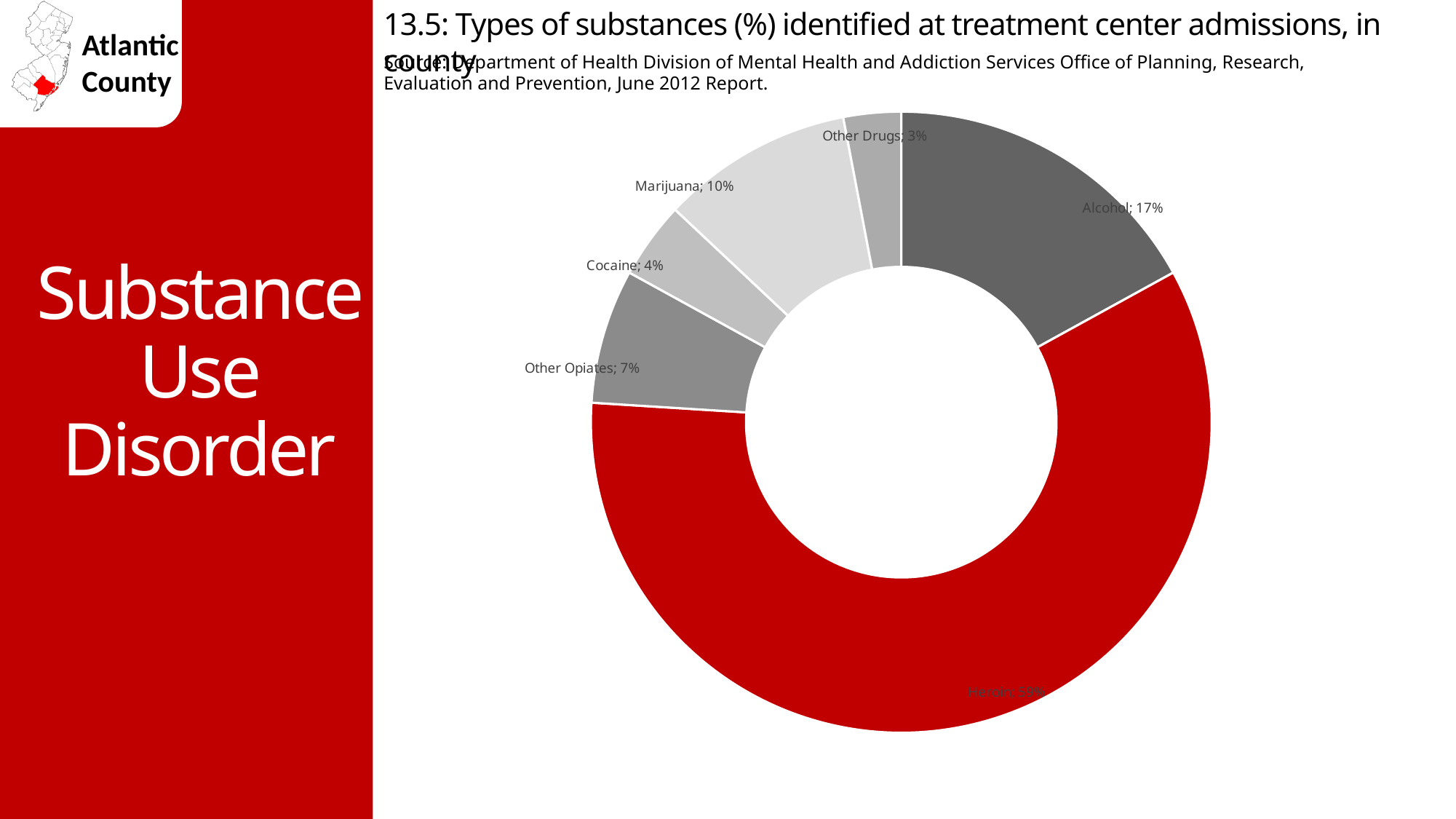
How many substance categories are shown in the chart? 6 What percentage of treatment center admissions is attributed to Alcohol? 17% What is the value shown for Other Opiates? 7% What percentage is shown for Marijuana? 10% Which substance accounts for the smallest share of admissions? Other Drugs What kind of chart is used on this slide? Doughnut (pie) chart What is the difference in percentage points between Alcohol and Marijuana? 7 What percentage is shown for Cocaine? 4% Which substance accounts for the largest share of admissions? Heroin Which has a larger share, Other Opiates or Cocaine? Other Opiates What percentage is shown for Other Drugs? 3% Which slice of the chart is coloured red? Heroin